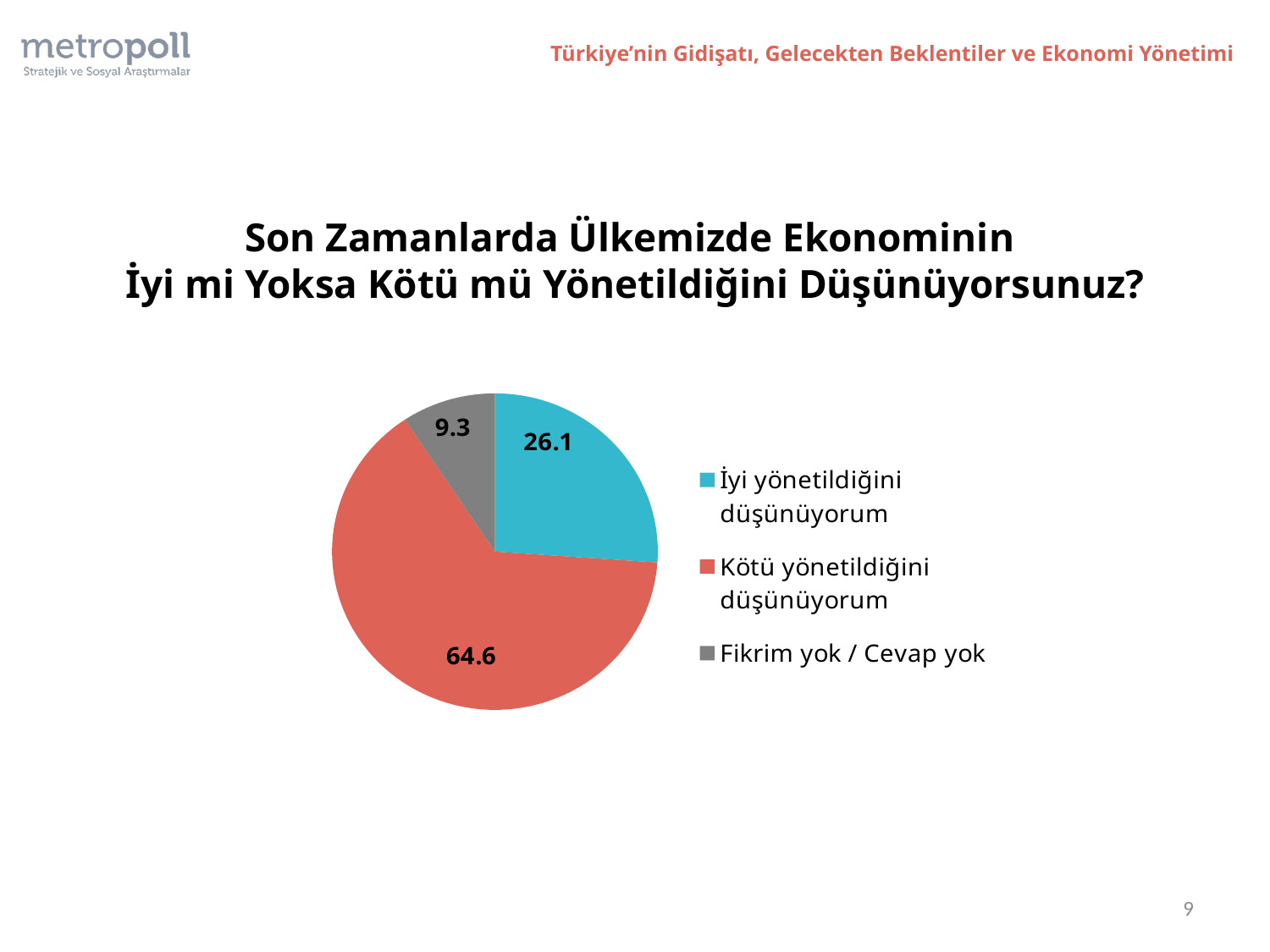
What is the difference between the values for "Kötü yönetildiğini düşünüyorum" and "İyi yönetildiğini düşünüyorum"? 38.5 What is the value for "Kötü yönetildiğini düşünüyorum"? 64.6 Which category has the largest slice of the pie? Kötü yönetildiğini düşünüyorum What colour is the slice for "Fikrim yok / Cevap yok"? grey How many categories does the pie chart have? 3 What colour is the slice for "Kötü yönetildiğini düşünüyorum"? red Which is larger: the value for "İyi yönetildiğini düşünüyorum" or the value for "Fikrim yok / Cevap yok"? İyi yönetildiğini düşünüyorum How many entries does the legend list? 3 What is the value for "İyi yönetildiğini düşünüyorum"? 26.1 Which category has the smallest slice of the pie? Fikrim yok / Cevap yok What kind of chart is shown on the slide? pie chart What is the value for "Fikrim yok / Cevap yok"? 9.3